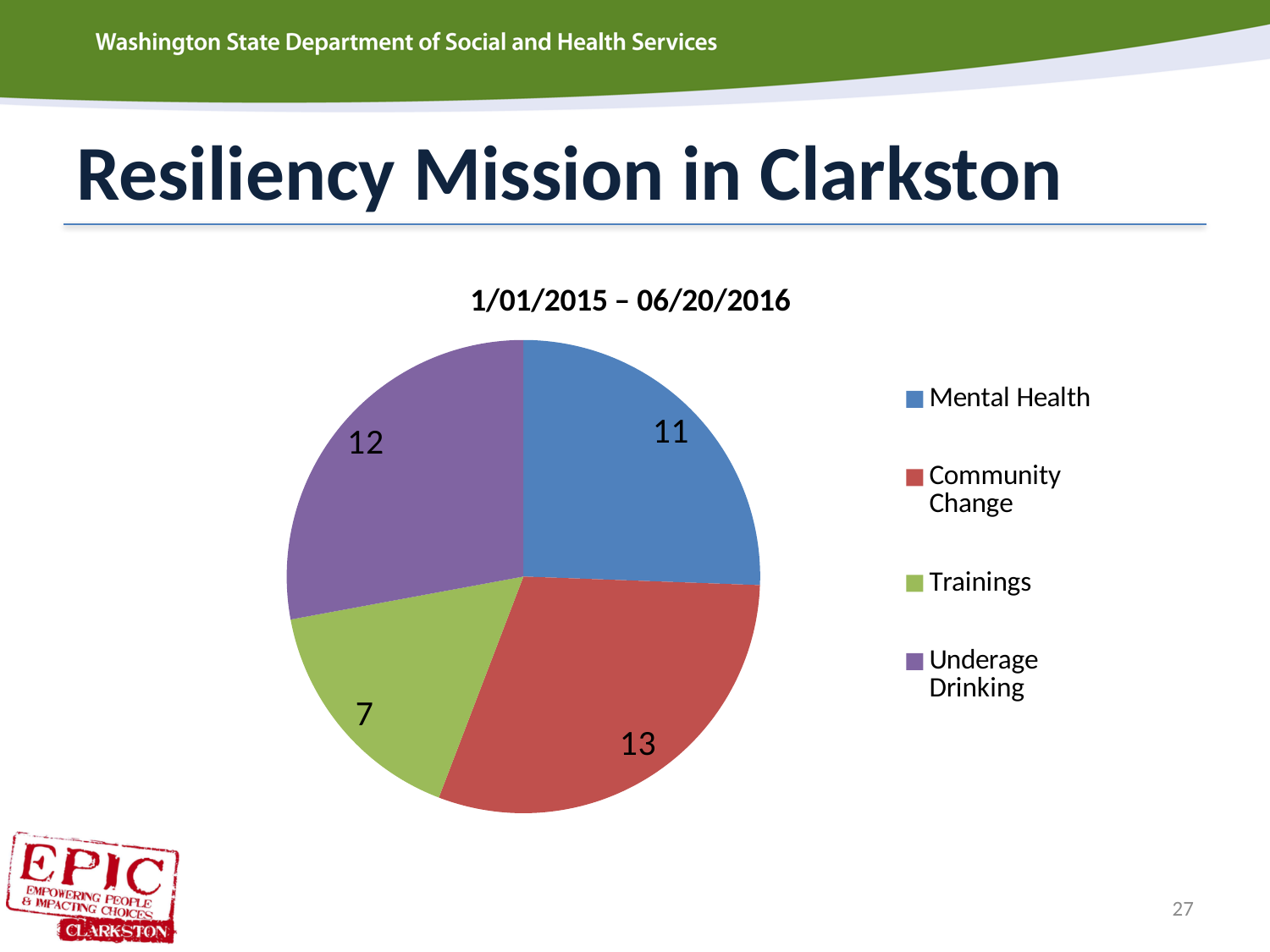
What is the value for Underage Drinking? 12 Which category has the smallest slice of the pie? Trainings How many categories does the pie chart have? 4 Which category has the largest slice of the pie? Community Change What date range is given in the chart title? 1/01/2015 – 06/20/2016 Which is larger, the value for Underage Drinking or the value for Mental Health? Underage Drinking What is the value for Trainings? 7 What is the difference between the values for Community Change and Trainings? 6 What is the total of all the slices in the pie chart? 43 What kind of chart is shown on the slide? pie chart What is the value for Community Change? 13 What is the value for Mental Health? 11